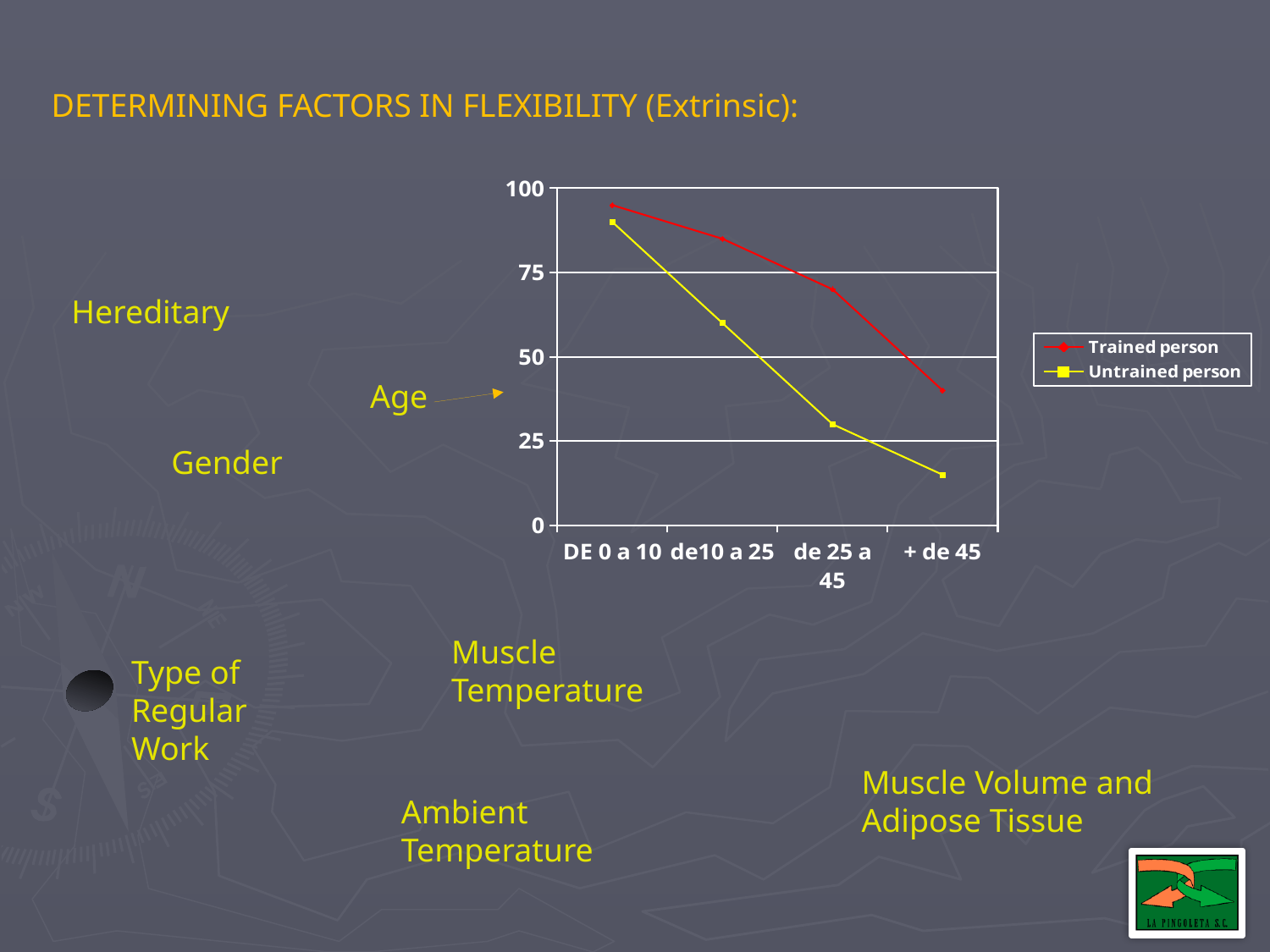
What kind of chart is shown on the slide? line chart Is the value for the Untrained person at 'de10 a 25' greater or less than 50? greater Do the values for the Trained person series rise or fall as age increases along the x axis? fall What colour is the line for the Untrained person series? yellow Is the value for the Trained person at '+ de 45' greater or less than 50? less Which age category has the lowest value for the Trained person series? + de 45 How many series does the chart legend list? 2 Which age category has the highest value for the Untrained person series? DE 0 a 10 At 'de 25 a 45', which series has the larger value, Trained person or Untrained person? Trained person Is the value for the Trained person at 'DE 0 a 10' greater or less than 75? greater How many age categories are plotted along the x axis of the chart? 4